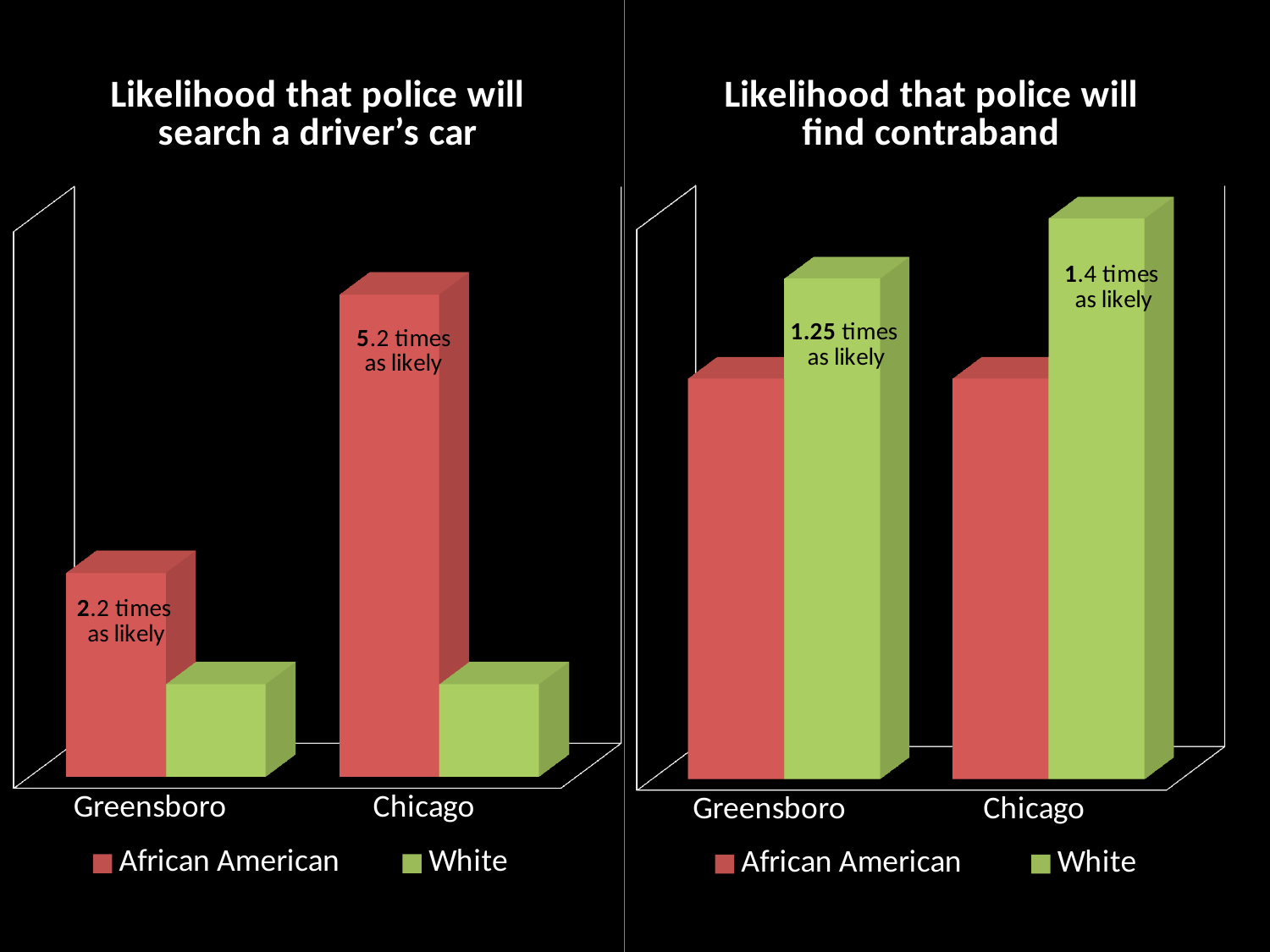
In the chart titled "Likelihood that police will find contraband", which bar is taller in Chicago, African American or White? White In the chart titled "Likelihood that police will find contraband", what is the value for White drivers in Greensboro? 1.25 times as likely In the chart titled "Likelihood that police will search a driver's car", what is the difference between the African American values for Chicago and Greensboro? 3.0 How many cities are shown on the x axis of the chart titled "Likelihood that police will find contraband"? 2 In the chart titled "Likelihood that police will find contraband", what is the value for White drivers in Chicago? 1.4 times as likely How many series does the legend list in the chart titled "Likelihood that police will search a driver's car"? 2 In the chart titled "Likelihood that police will search a driver's car", what is the value for African American drivers in Chicago? 5.2 times as likely In the chart titled "Likelihood that police will search a driver's car", which bar is taller in Greensboro, African American or White? African American In the chart titled "Likelihood that police will search a driver's car", what is the value for African American drivers in Greensboro? 2.2 times as likely In the chart titled "Likelihood that police will find contraband", which city has the lower value for White drivers? Greensboro What kind of chart is the chart titled "Likelihood that police will find contraband"? Bar chart In the chart titled "Likelihood that police will search a driver's car", which city has the higher value for African American drivers? Chicago